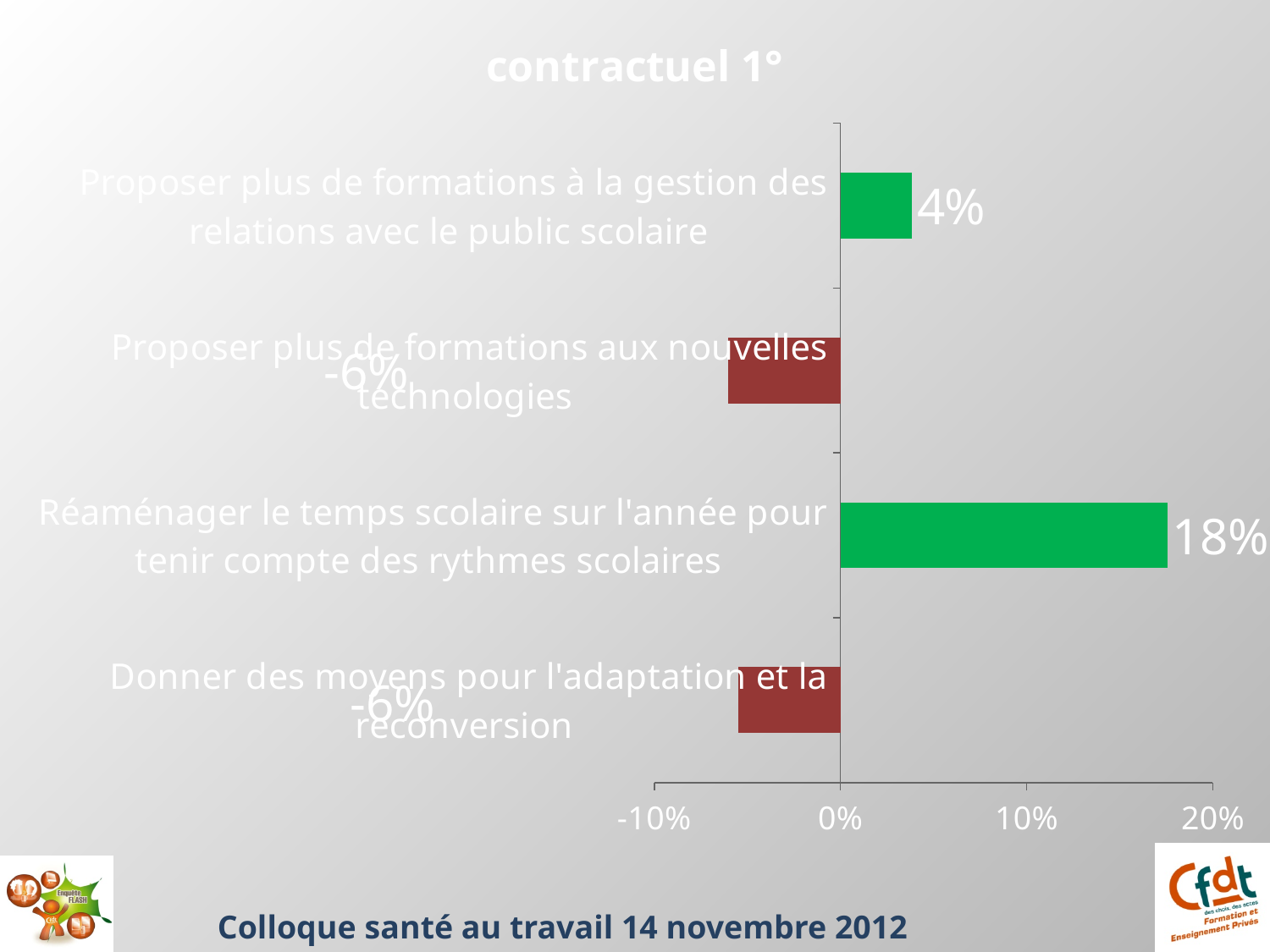
What kind of chart is shown on the slide? bar chart What is the title of the chart? contractuel 1° What is the value for "Proposer plus de formations à la gestion des relations avec le public scolaire"? 4% How many categories have a negative value? 2 What is the difference between the value for "Réaménager le temps scolaire sur l'année pour tenir compte des rythmes scolaires" and the value for "Proposer plus de formations à la gestion des relations avec le public scolaire"? 14% How many categories are shown in the chart? 4 What is the value for "Donner des moyens pour l'adaptation et la reconversion"? -6% Which category has the highest value? Réaménager le temps scolaire sur l'année pour tenir compte des rythmes scolaires What is the value for "Proposer plus de formations aux nouvelles technologies"? -6% Which is larger: the value for "Proposer plus de formations à la gestion des relations avec le public scolaire" or the value for "Proposer plus de formations aux nouvelles technologies"? Proposer plus de formations à la gestion des relations avec le public scolaire Is the value for "Réaménager le temps scolaire sur l'année pour tenir compte des rythmes scolaires" greater or less than 10%? greater What is the value for "Réaménager le temps scolaire sur l'année pour tenir compte des rythmes scolaires"? 18%